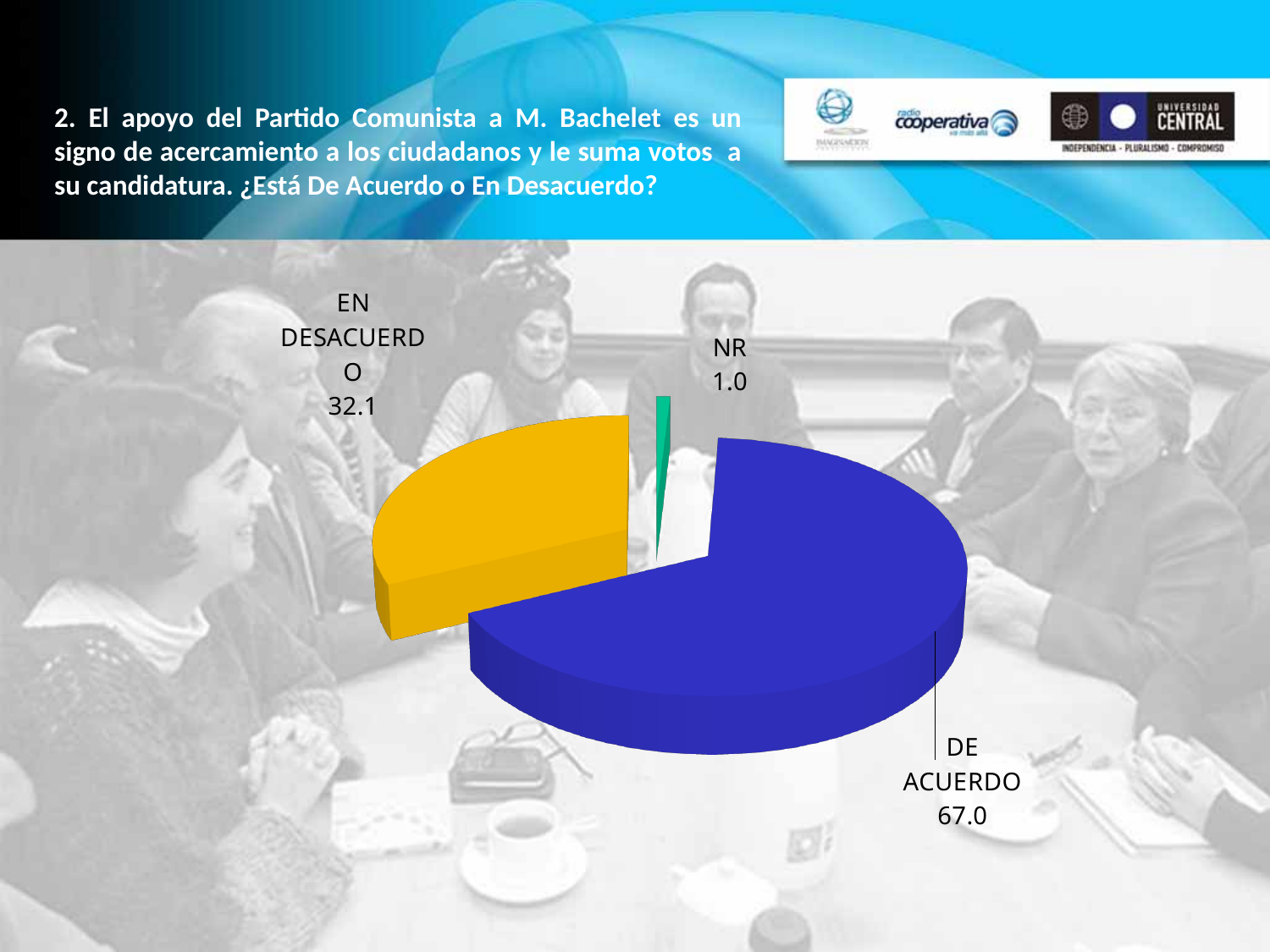
Which category has the largest slice? DE ACUERDO Which is larger, EN DESACUERDO or NR? EN DESACUERDO What is the difference between DE ACUERDO and EN DESACUERDO? 34.9 What colour is the DE ACUERDO slice? Blue What colour is the EN DESACUERDO slice? Yellow How many slices does the pie chart have? 3 What is the value for NR? 1.0 What type of chart is shown on the slide? Pie chart What is the value for EN DESACUERDO? 32.1 Which category has the smallest slice? NR What is the value for DE ACUERDO? 67.0